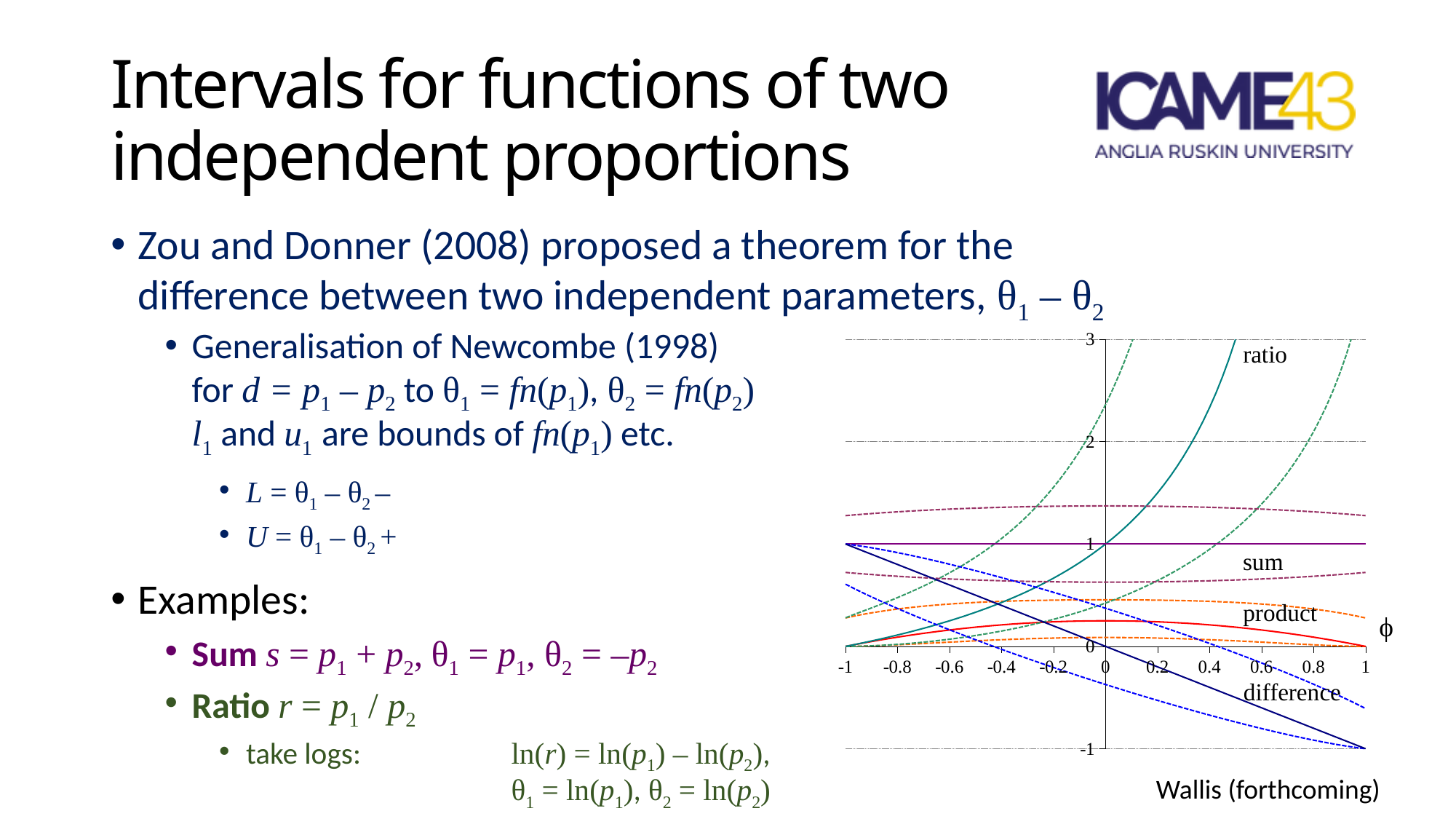
What is the maximum value shown on the vertical axis of the chart? 3 Does the solid 'ratio' curve rise or fall as φ increases from -1 to 1? rise Is the value of the solid 'product' curve at φ = 0 greater or less than 1? less Which curve in the chart is labelled as the one that rises most steeply toward the right? ratio At φ = 0.8, which solid curve is higher: 'ratio' or 'sum'? ratio Is the value of the solid 'ratio' curve at φ = 0.4 greater or less than 2? greater Does the solid 'difference' line rise or fall as φ increases from -1 to 1? fall What is the value of the solid 'difference' line at φ = 1? -1 What is the value of the solid 'sum' line at φ = 0? 1 How many labelled curves are shown in the chart (ratio, sum, product, difference)? 4 What kind of chart is shown on the right of the slide? line chart What is the value of the solid 'difference' line at φ = -1? 1